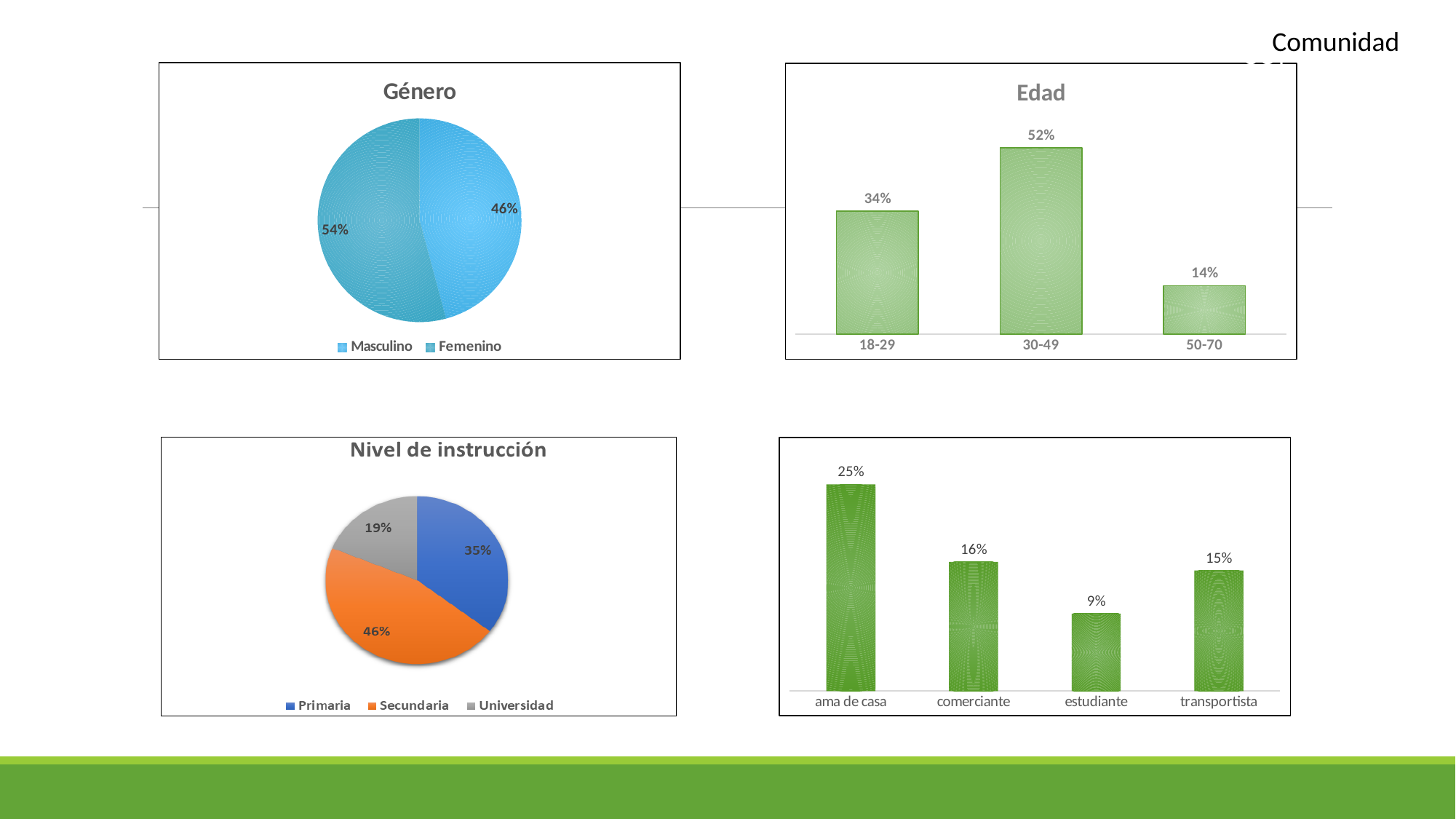
In the 'Edad' chart, what is the value for the 30-49 group? 52% In the bottom-right bar chart, what is the value for estudiante? 9% In the bottom-right bar chart, what is the difference between ama de casa and transportista? 10% In the 'Género' pie chart, what percentage is Masculino? 46% In the 'Nivel de instrucción' pie chart, which category has the smallest share? Universidad In the bottom-right bar chart, which category has the highest value? ama de casa In the 'Nivel de instrucción' pie chart, what percentage is Secundaria? 46% In the 'Género' pie chart, which category has the larger share? Femenino In the 'Edad' chart, which age group has the lowest value? 50-70 In the 'Edad' chart, what is the difference between the 30-49 and 18-29 values? 18% In the 'Nivel de instrucción' pie chart, how many categories does the legend list? 3 In the 'Edad' chart, how many age groups are shown? 3